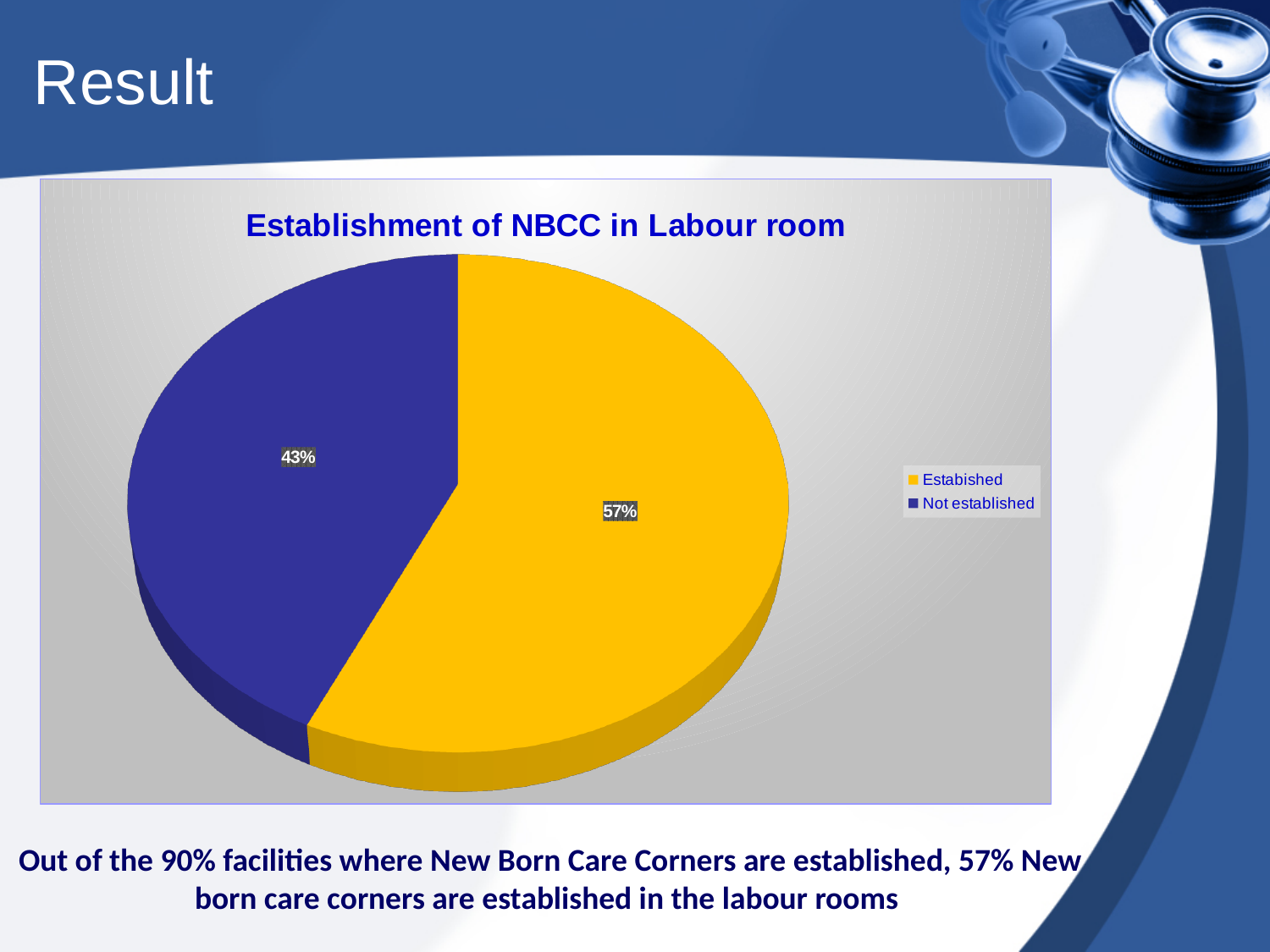
What colour is the Not established slice? Blue Which slice of the pie is the largest? Estabished What type of chart is shown on the slide? Pie chart What share of the pie is labelled Estabished? 57% How many slices does the pie chart have? 2 Which is larger, the Estabished slice or the Not established slice? Estabished What share of the pie is labelled Not established? 43% What is the title of the chart? Establishment of NBCC in Labour room How many entries does the legend list? 2 Is the share for Not established greater or less than 50%? less What is the difference in percentage points between the Estabished and Not established slices? 14 Which slice of the pie is the smallest? Not established